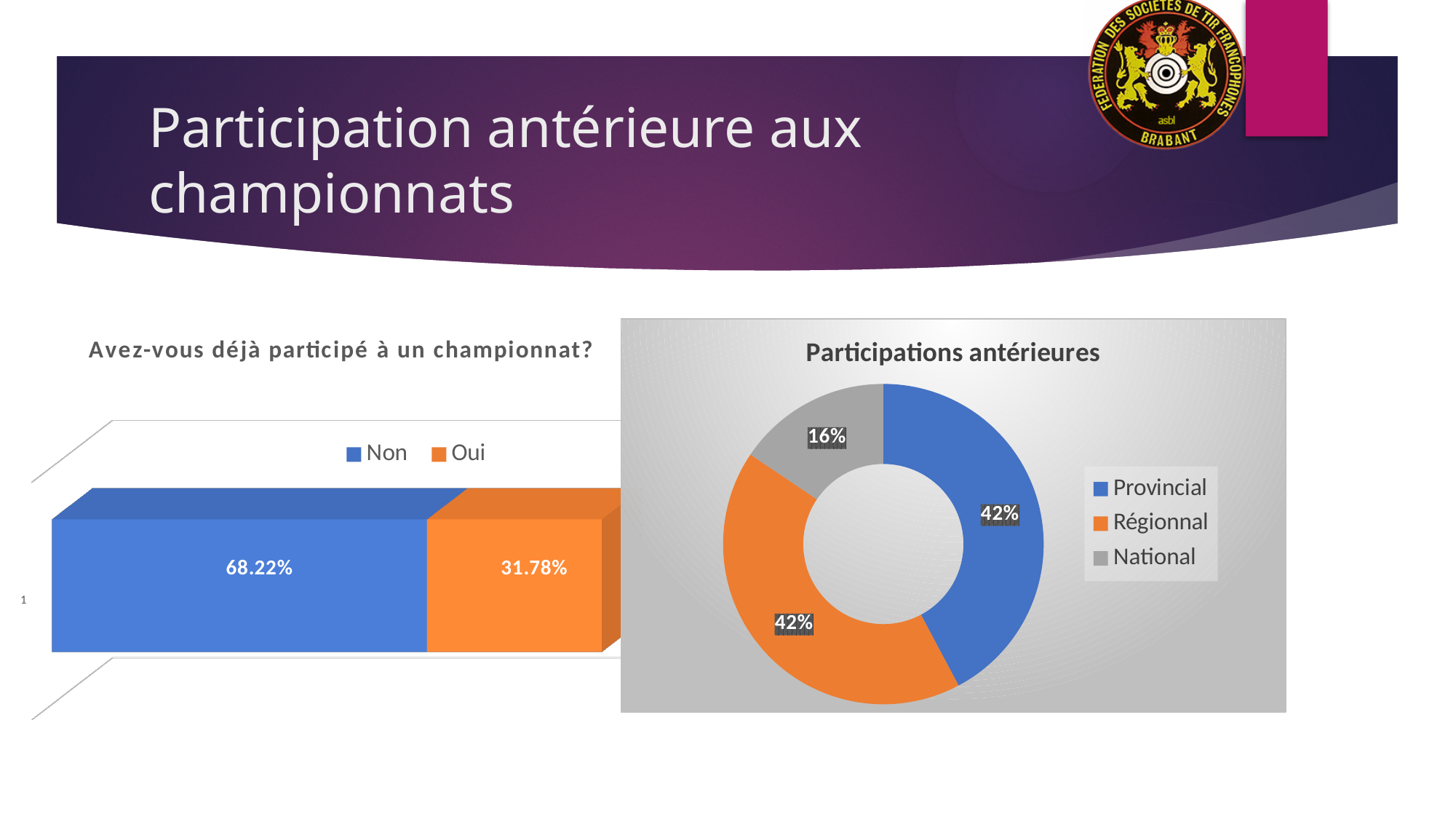
In the chart titled "Avez-vous déjà participé à un championnat?", which series is larger, Non or Oui? Non What kind of chart is the one titled "Participations antérieures"? Doughnut chart In the chart titled "Participations antérieures", what is the value for Provincial? 42% In the chart titled "Participations antérieures", how many categories are shown? 3 In the chart titled "Participations antérieures", what is the value for National? 16% In the chart titled "Avez-vous déjà participé à un championnat?", what is the value for Non? 68.22% In the chart titled "Avez-vous déjà participé à un championnat?", how many series does the legend list? 2 In the chart titled "Participations antérieures", which category has the lowest value? National In the chart titled "Participations antérieures", which colour represents Régionnal? Orange What kind of chart is the one titled "Avez-vous déjà participé à un championnat?"? Bar chart In the chart titled "Avez-vous déjà participé à un championnat?", what is the value for Oui? 31.78% In the chart titled "Avez-vous déjà participé à un championnat?", what is the difference between the Non and Oui values? 36.44%